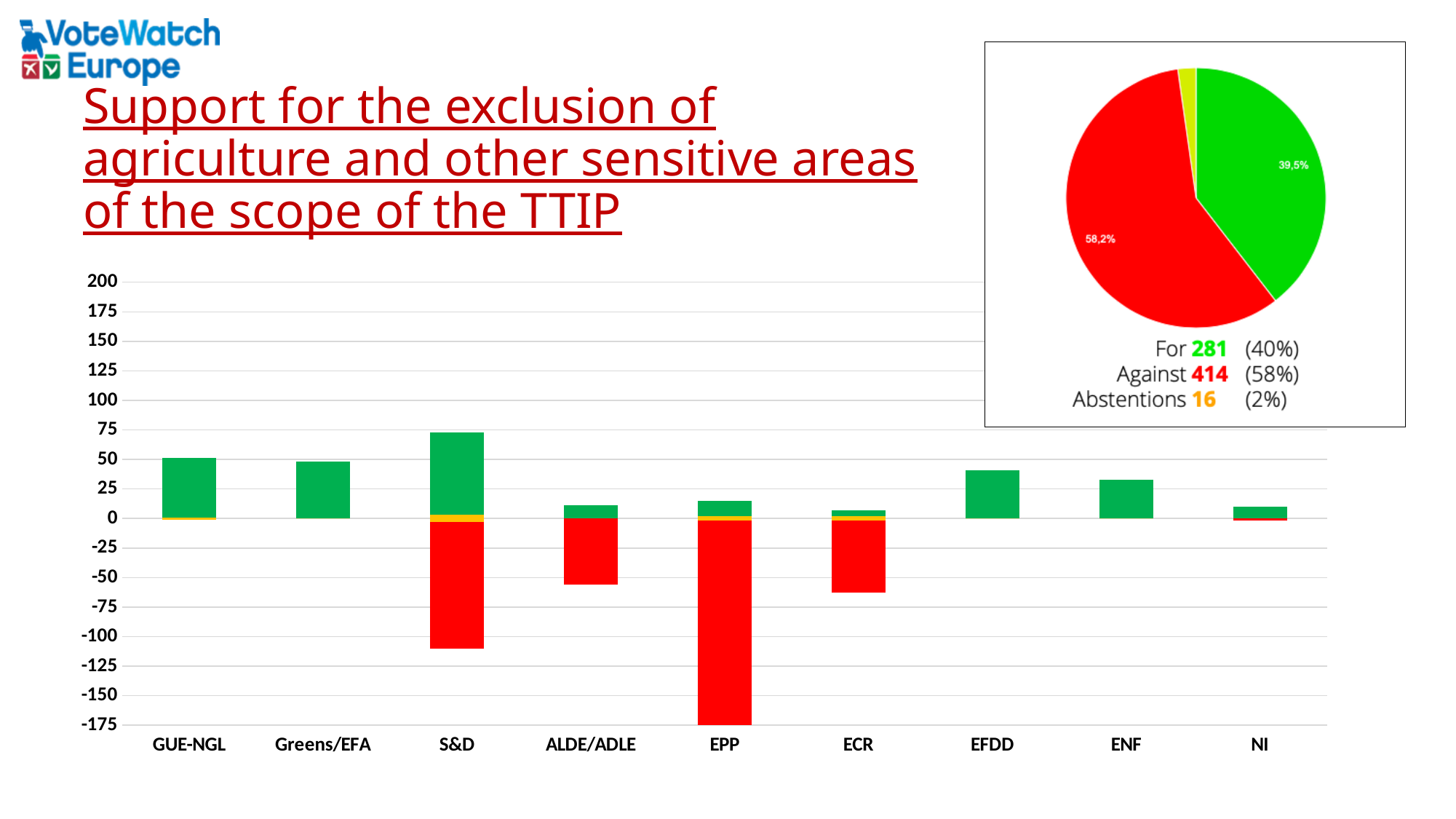
In the pie chart, what is the difference between the Against and For vote counts? 133 In the bar chart, which group has the longest red (negative) bar? EPP In the pie chart, how many votes were cast Against? 414 In the bar chart, is the red (negative) value for EPP greater or less than -150? less What kind of chart is the large chart at the bottom of the slide? bar chart In the bar chart, is the green (positive) value for S&D greater or less than 50? greater In the pie chart, what share of the votes were For? 40% In the bar chart, is the red (negative) value for S&D greater or less than -100? less How many political groups are shown on the x axis of the bar chart? 9 In the bar chart, which group has the shortest green (positive) bar? ECR In the bar chart, which group has the tallest green (positive) bar? S&D